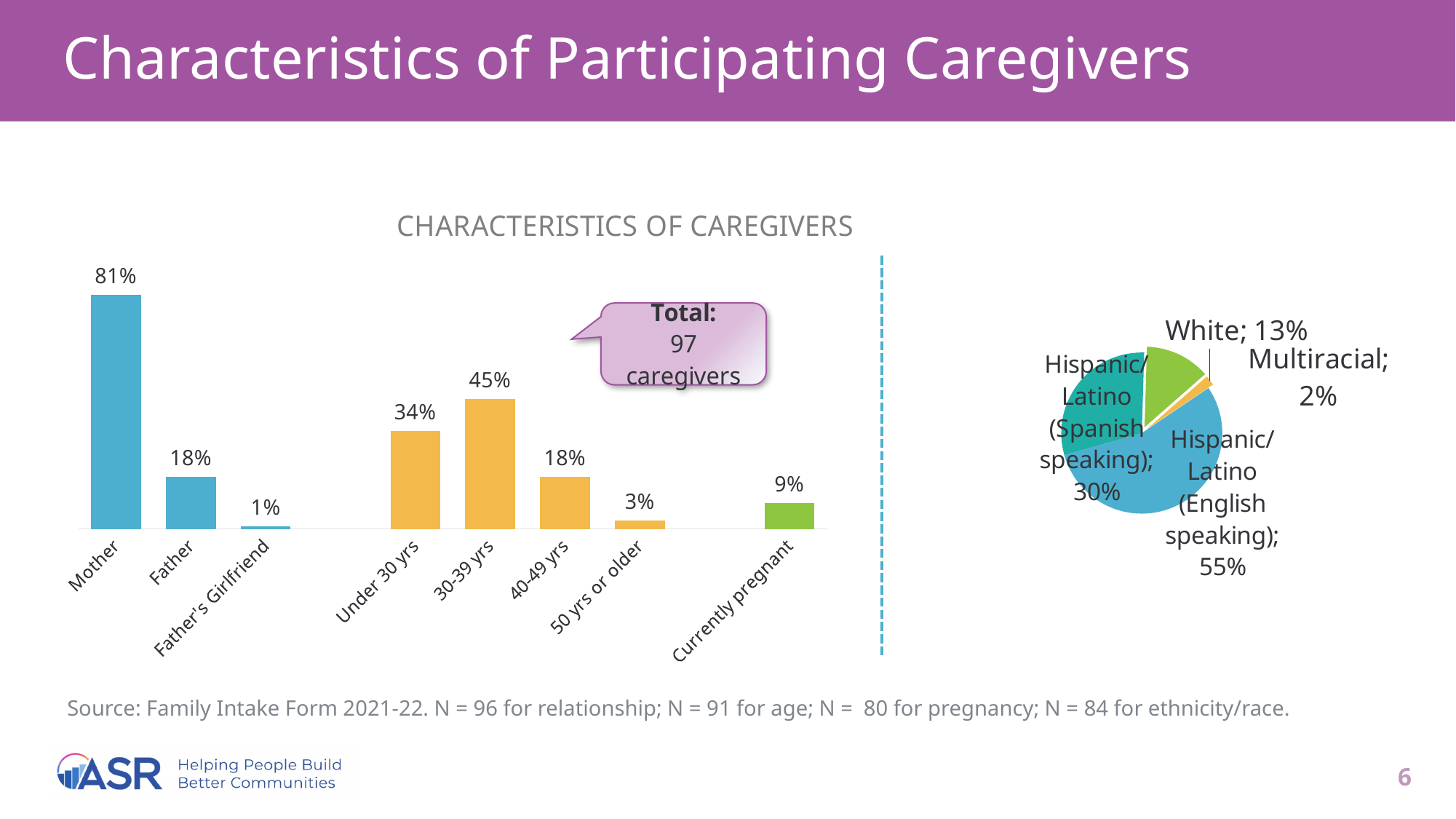
In the bar chart, what is the difference between the Mother and Father values? 63% In the pie chart, what share is Hispanic/Latino (English speaking)? 55% In the bar chart, what is the value for the 30-39 yrs category? 45% In the bar chart, which age group has the highest value? 30-39 yrs In the bar chart, what is the value for Currently pregnant? 9% In the bar chart, which is larger, the value for Under 30 yrs or the value for 40-49 yrs? Under 30 yrs In the pie chart, which slice is the smallest? Multiracial In the bar chart, which category has the lowest value? Father's Girlfriend How many categories are shown in the bar chart? 8 In the bar chart, what percentage of caregivers are mothers? 81% According to the callout on the bar chart, what is the total number of caregivers? 97 caregivers What type of chart is on the right side of the slide? Pie chart